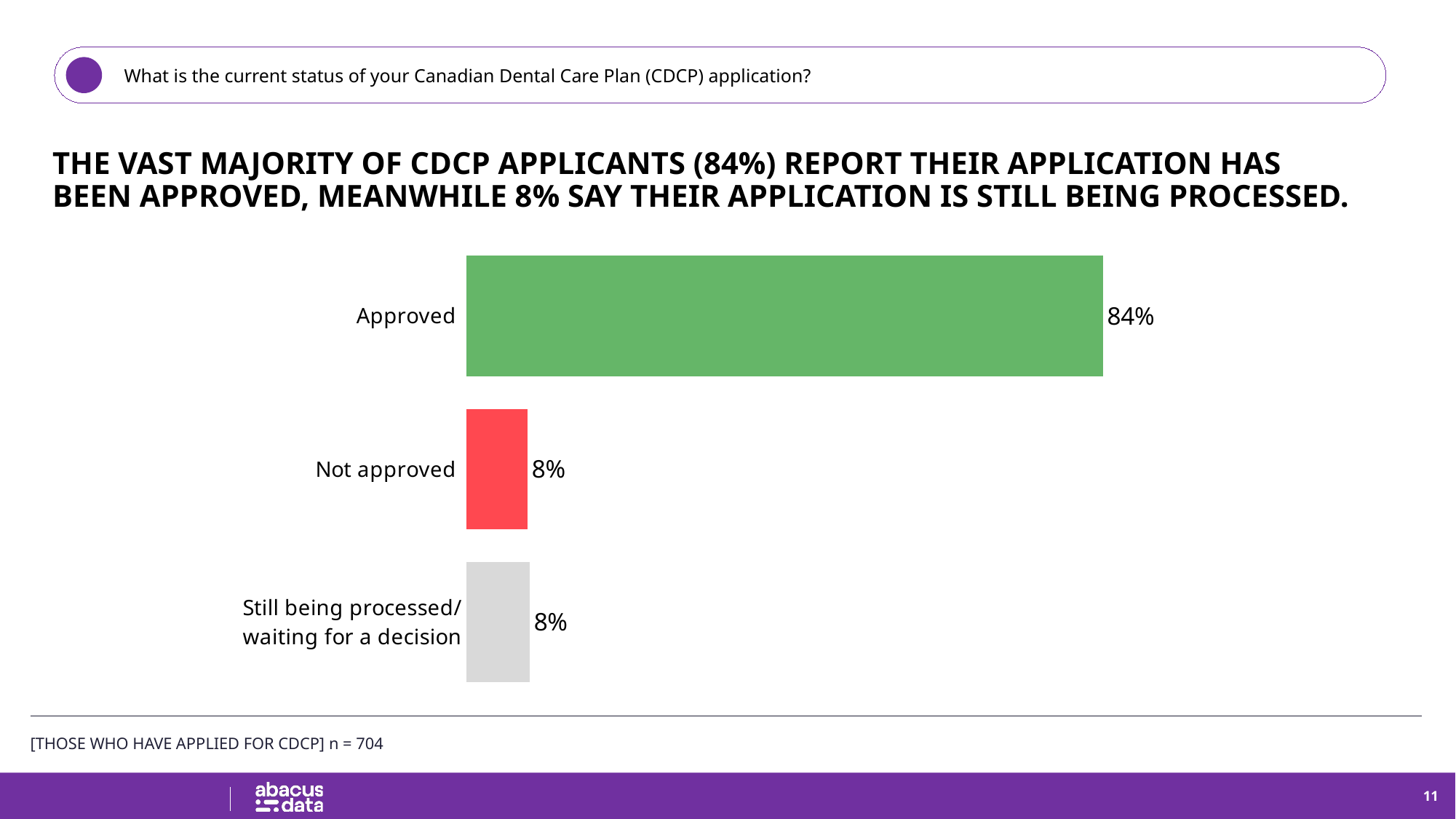
Which application status has the highest percentage? Approved How many application status categories are shown in the chart? 3 What percentage of CDCP applicants report their application was approved? 84% What is the combined percentage of Not approved and Still being processed/waiting for a decision? 16% What kind of chart is shown on the slide? Bar chart What is the difference in percentage points between Approved and Not approved? 76 Which is larger, the value for Approved or the value for Still being processed/waiting for a decision? Approved What is the sample size (n) noted for those who have applied for CDCP? 704 What percentage of CDCP applicants say their application is still being processed/waiting for a decision? 8% What colour is the bar for Approved? Green What percentage of CDCP applicants report their application was not approved? 8%